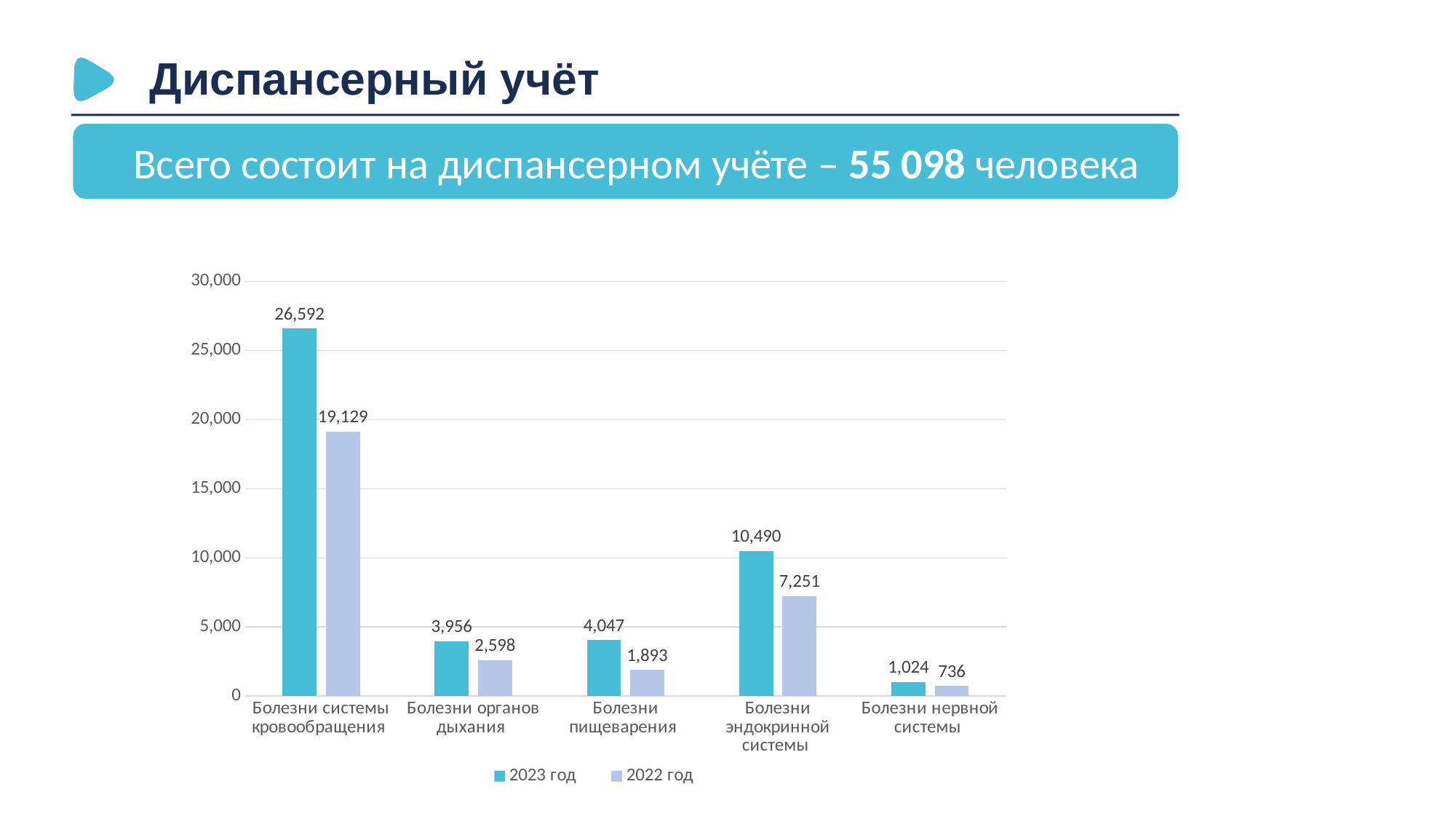
Which category has the lowest value in the 2023 год series? Болезни нервной системы What is the value for Болезни нервной системы in the 2023 год series? 1,024 Which category has the highest value in the 2022 год series? Болезни системы кровообращения Which is larger: the 2023 год value for Болезни пищеварения or the 2023 год value for Болезни органов дыхания? Болезни пищеварения What kind of chart is shown on the slide? Bar chart What is the difference between the 2023 год and 2022 год values for Болезни системы кровообращения? 7,463 How many categories are shown on the x axis of the chart? 5 How many series does the chart legend list? 2 What is the difference between the 2023 год and 2022 год values for Болезни органов дыхания? 1,358 Is the 2023 год value for Болезни эндокринной системы greater or less than 10,000? greater What is the value for Болезни системы кровообращения in the 2023 год series? 26,592 What is the value for Болезни эндокринной системы in the 2022 год series? 7,251